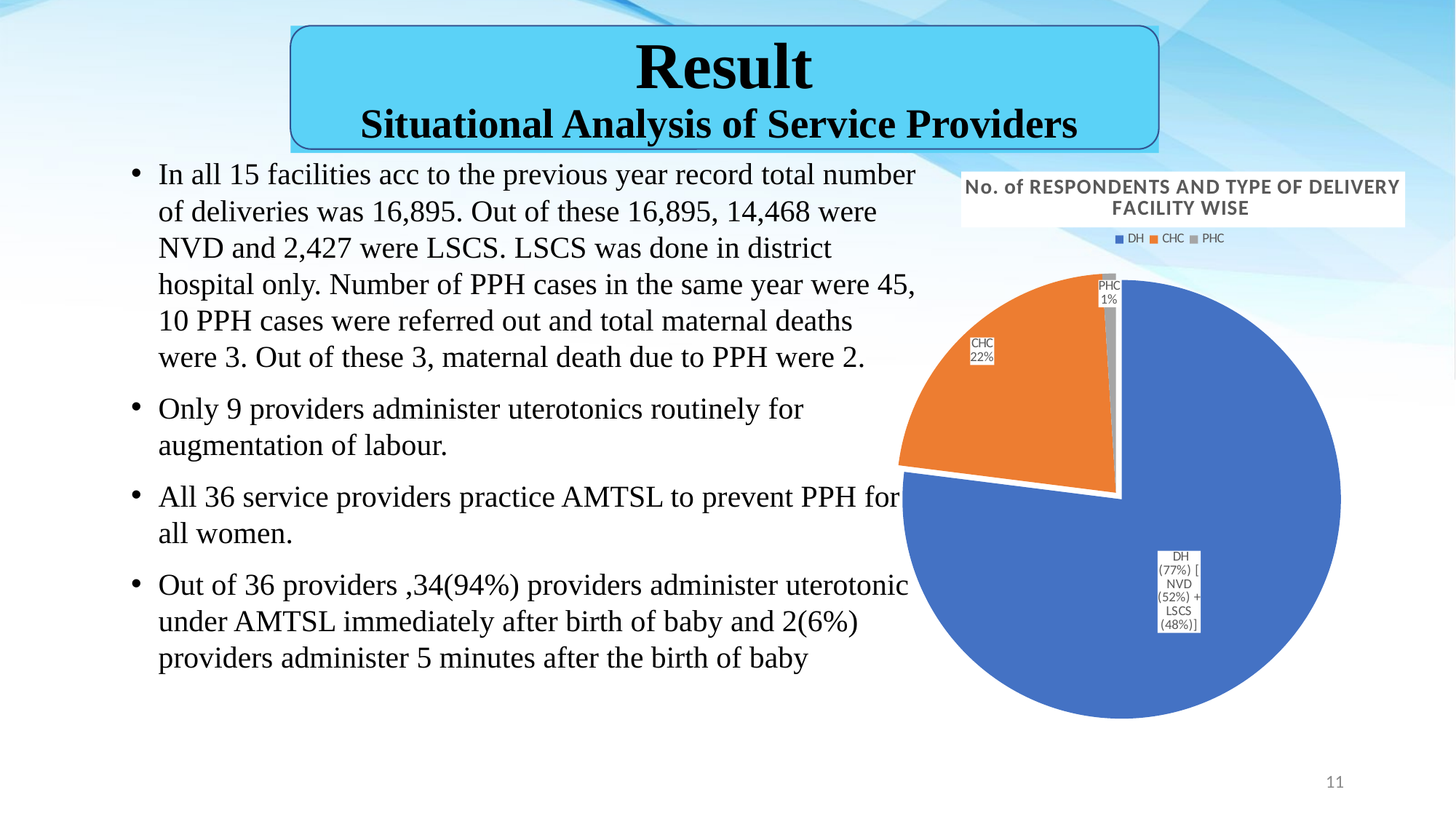
What is the title of the chart? No. of RESPONDENTS AND TYPE OF DELIVERY FACILITY WISE What share of the pie does DH represent? 77% Which colour represents CHC in the pie chart? orange What is the difference in percentage points between the DH share and the CHC share? 55 What share of the pie does CHC represent? 22% What share of the pie does PHC represent? 1% How many series does the chart legend list? 3 Which is larger, the CHC slice or the PHC slice? CHC Which facility type has the largest slice of the pie? DH Which facility type has the smallest slice of the pie? PHC How many slices does the pie chart have? 3 What kind of chart is shown on the slide? pie chart